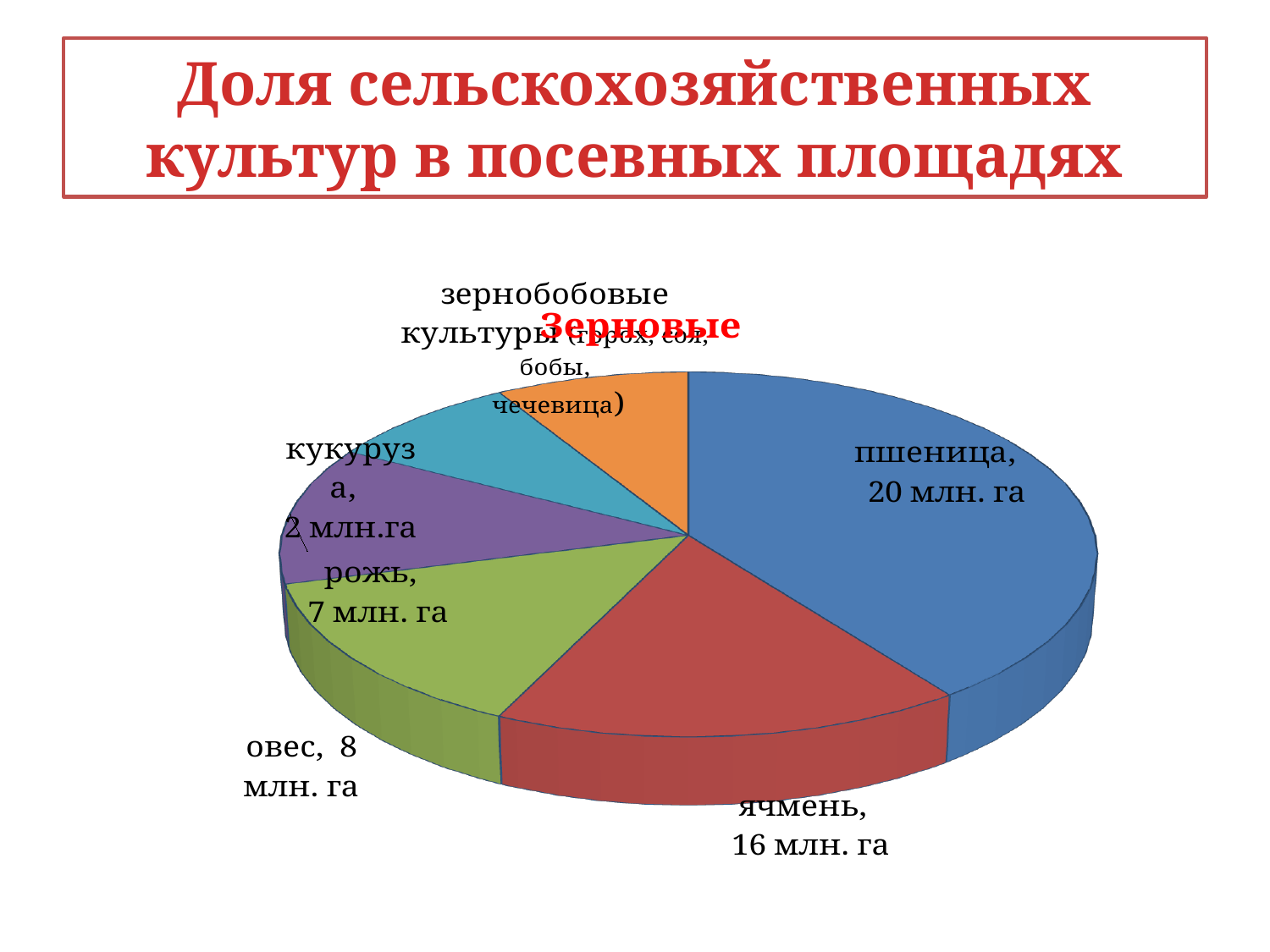
Which crop has the largest slice in the pie chart? пшеница Which is larger, the value for ячмень or the value for овес? ячмень How many crop categories are labelled in the pie chart? 6 What is the value shown for ячмень in the pie chart? 16 млн. га What is the value shown for овес in the pie chart? 8 млн. га What is the value shown for рожь in the pie chart? 7 млн. га What is the value shown for кукуруза in the pie chart? 2 млн.га By how much does the value for пшеница exceed the value for ячмень? 4 млн. га What is the title printed in red above the pie chart? Зерновые What kind of chart is shown on the slide? pie chart What is the value shown for пшеница in the pie chart? 20 млн. га What is the difference between the values for овес and рожь? 1 млн. га